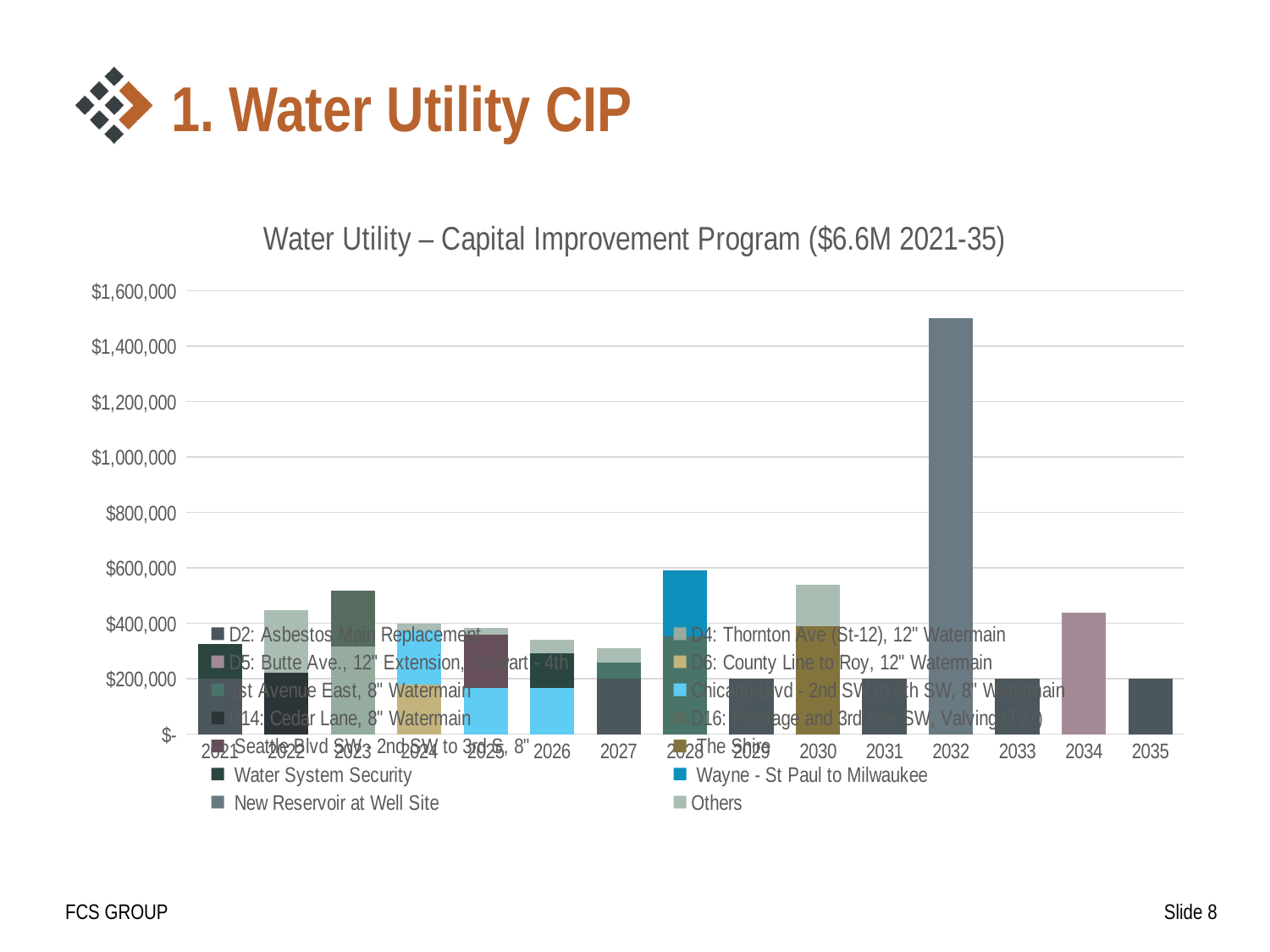
Is the total value for 2035 greater or less than $400,000? less Which year has the larger total, 2032 or 2028? 2032 What kind of chart is shown on the slide? stacked bar chart Which year has the larger total, 2034 or 2033? 2034 What is the title of the chart? Water Utility – Capital Improvement Program ($6.6M 2021-35) How many years are shown along the x axis of the chart? 15 Is the total value for 2028 greater or less than $400,000? greater Is the total value for 2030 greater or less than $400,000? greater Which year has the highest total capital spending in the chart? 2032 How many series does the chart legend list? 14